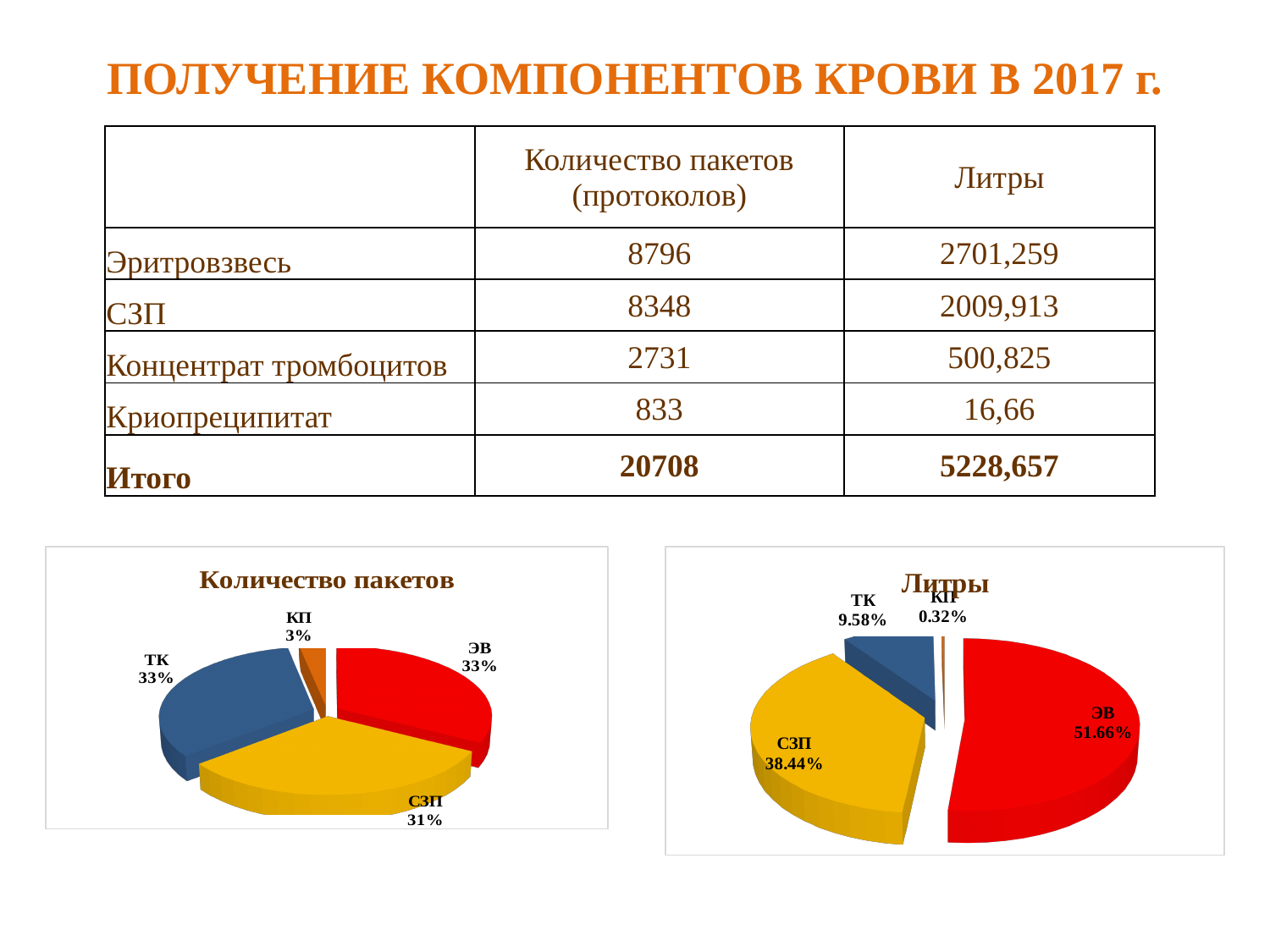
In the "Литры" chart, which category has the largest slice? ЭВ In the "Количество пакетов" chart, what share is labelled for КП? 3% In the "Литры" chart, what share is labelled for ТК? 9.58% In the "Литры" chart, which slice is larger, СЗП or ТК? СЗП In the "Литры" chart, what is the difference between the shares of ЭВ and СЗП? 13.22% What kind of chart is the "Количество пакетов" chart? Pie chart In the "Литры" chart, what share is labelled for КП? 0.32% In the "Количество пакетов" chart, how many slices does the pie have? 4 In the "Количество пакетов" chart, which category has the smallest slice? КП In the "Литры" chart, what share is labelled for ЭВ? 51.66% In the "Количество пакетов" chart, what share is labelled for СЗП? 31% In the "Литры" chart, which category has the smallest slice? КП